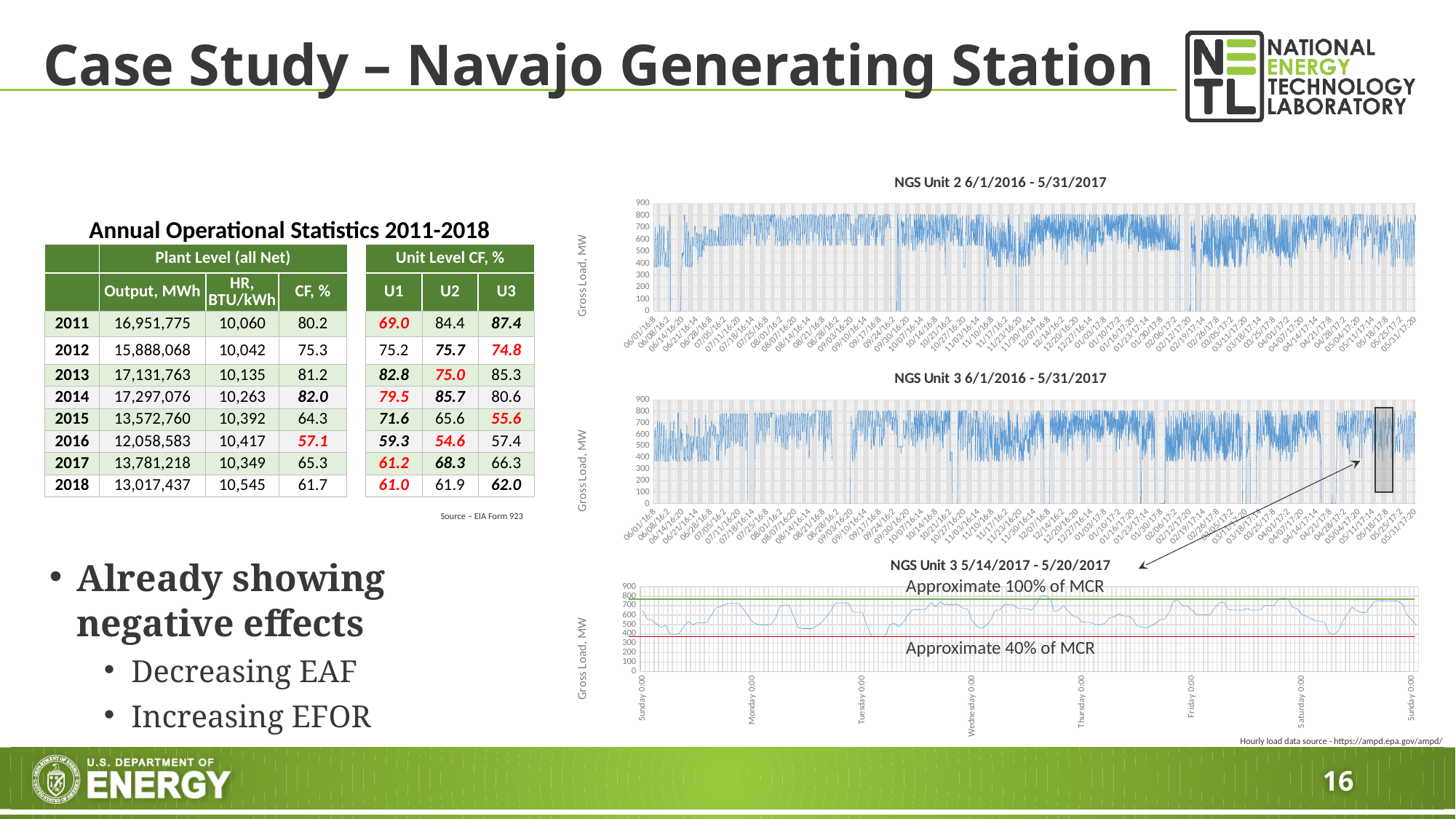
What kind of chart is the top chart titled 'NGS Unit 2 6/1/2016 - 5/31/2017'? Line chart What is the y-axis label on the charts on the right side of the slide? Gross Load, MW What kind of chart is the bottom chart titled 'NGS Unit 3 5/14/2017 - 5/20/2017'? Line chart What is the highest tick value shown on the y axis of the top chart 'NGS Unit 2 6/1/2016 - 5/31/2017'? 900 In the bottom chart 'NGS Unit 3 5/14/2017 - 5/20/2017', what does the red horizontal reference line represent? Approximate 40% of MCR How many day-of-week tick labels appear on the x axis of the bottom chart 'NGS Unit 3 5/14/2017 - 5/20/2017'? 8 In the bottom chart 'NGS Unit 3 5/14/2017 - 5/20/2017', is the highest gross load value greater or less than 500? greater In the middle chart 'NGS Unit 3 6/1/2016 - 5/31/2017', is the lowest gross load value greater or less than 300? less How many charts are shown on the right side of the slide? 3 In the bottom chart 'NGS Unit 3 5/14/2017 - 5/20/2017', is the lowest gross load value greater or less than 100? greater